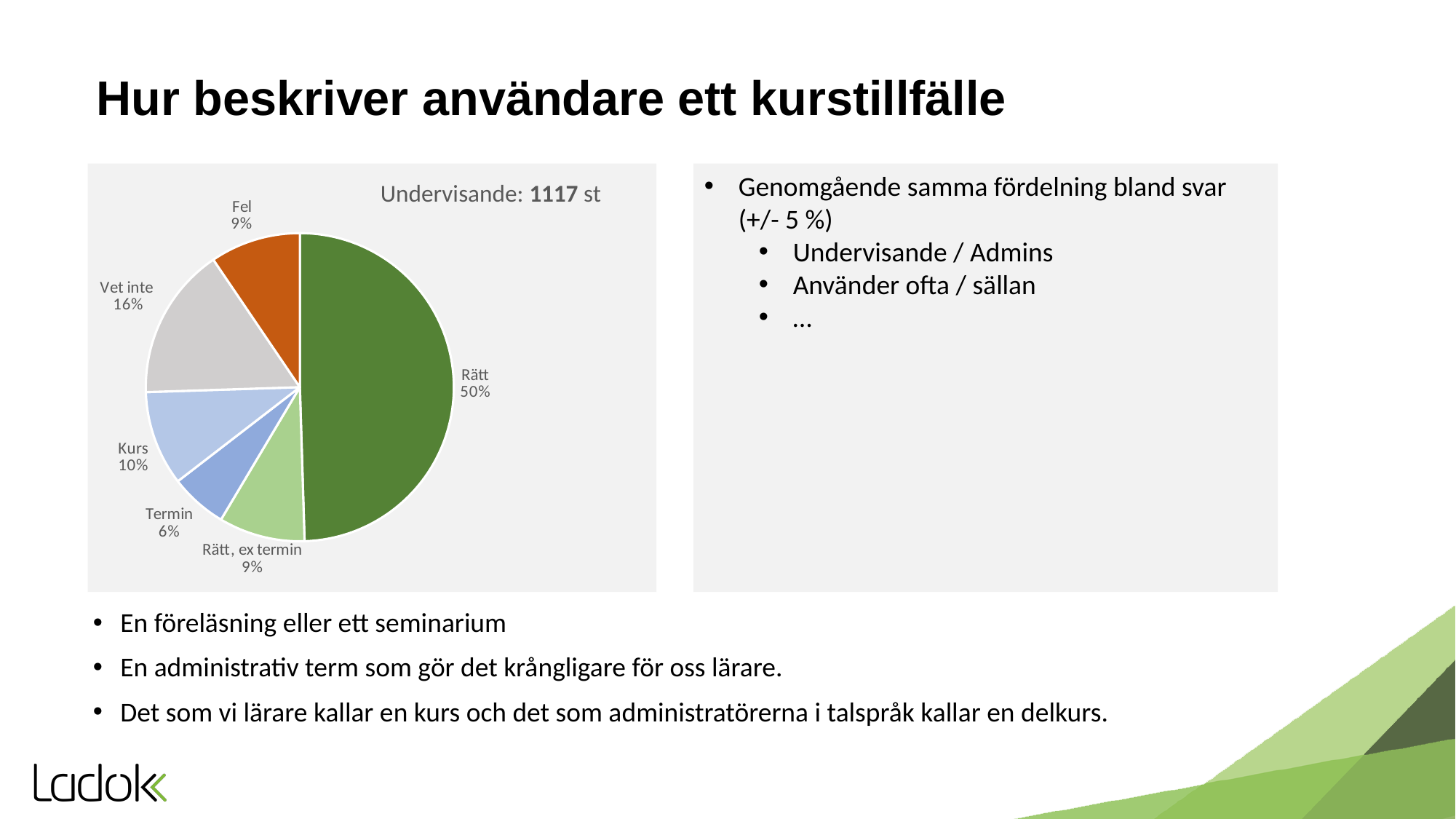
What percentage is shown for "Rätt, ex termin"? 9% What percentage is shown for "Vet inte"? 16% How many slices does the pie chart have? 6 Which category has the largest slice of the pie? Rätt What kind of chart is shown on the slide? pie chart According to the chart's title, how many "Undervisande" respondents are there? 1117 Which category has the smallest slice of the pie? Termin What share of the pie does the "Rätt" slice represent? 50% What percentage is shown for "Termin"? 6% Which is larger, the share for "Vet inte" or the share for "Fel"? Vet inte What is the difference in percentage points between "Vet inte" and "Kurs"? 6 What percentage is shown for "Kurs"? 10%